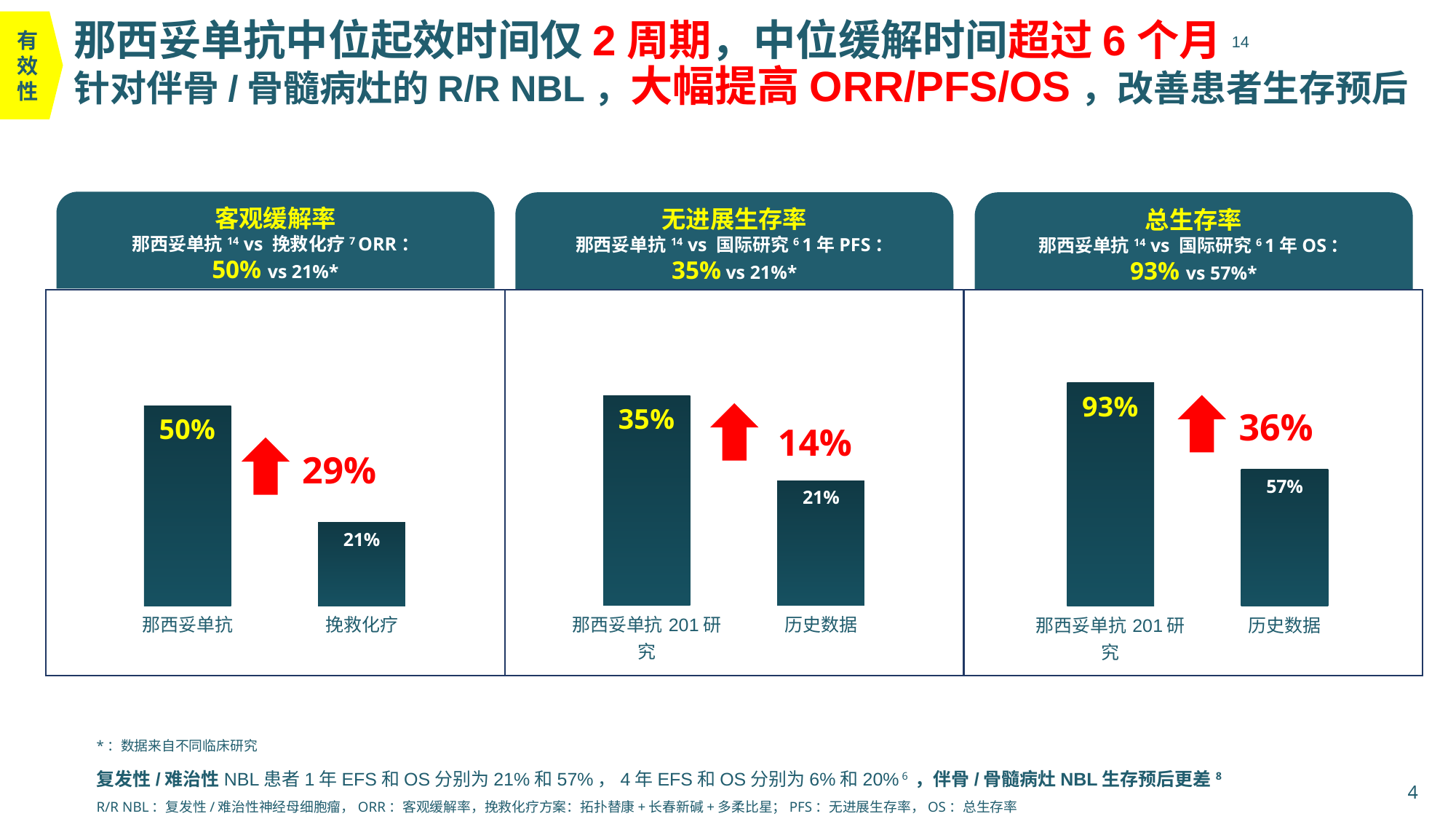
In the 无进展生存率 chart, which category has the lowest value? 历史数据 In the 无进展生存率 chart, what is the value for 那西妥单抗 201 研究? 35% In the 客观缓解率 chart, what is the value for 挽救化疗? 21% How many charts are shown on the slide? 3 What kind of chart is the 总生存率 chart? bar chart In the 总生存率 chart, what is the difference between the values for 那西妥单抗 201 研究 and 历史数据? 36% In the 总生存率 chart, which category has the highest value? 那西妥单抗 201 研究 In the 总生存率 chart, what is the value for 历史数据? 57% In the 客观缓解率 chart, what is the value for 那西妥单抗? 50% In the 无进展生存率 chart, which is larger: the value for 那西妥单抗 201 研究 or the value for 历史数据? 那西妥单抗 201 研究 In the 客观缓解率 chart, what is the difference between the values for 那西妥单抗 and 挽救化疗? 29% How many bars are in the 客观缓解率 chart? 2